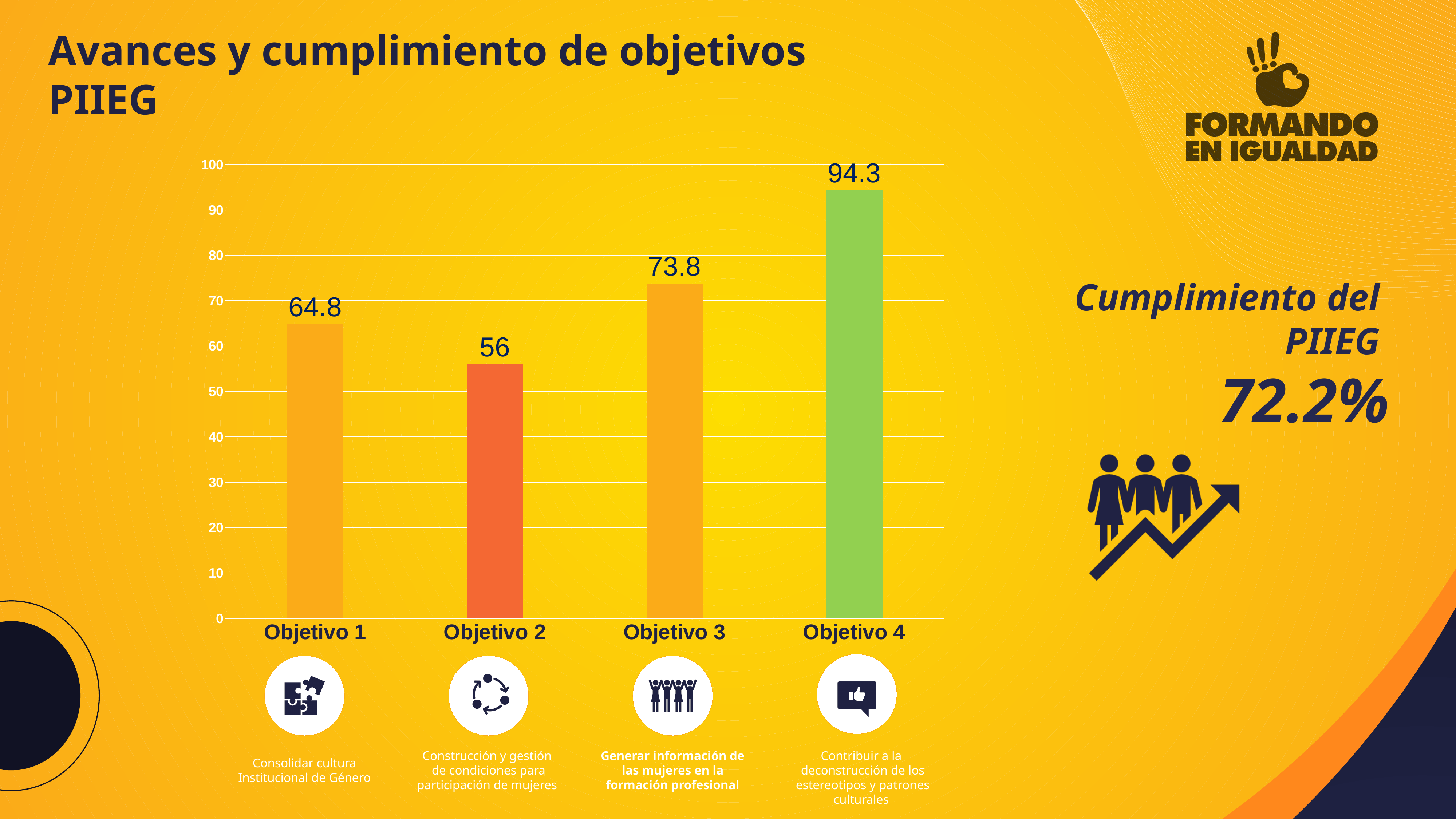
What kind of chart is shown on the slide? bar chart Which objetivo has the lowest value? Objetivo 2 How many objetivos are shown in the chart? 4 Which objetivo has the highest value? Objetivo 4 What is the value for Objetivo 2? 56 What is the value for Objetivo 3? 73.8 What is the difference between the values for Objetivo 4 and Objetivo 2? 38.3 Which is larger, the value for Objetivo 1 or Objetivo 3? Objetivo 3 Is the value for Objetivo 2 greater or less than 60? less What is the value for Objetivo 1? 64.8 What is the difference between the values for Objetivo 3 and Objetivo 1? 9 What is the value for Objetivo 4? 94.3